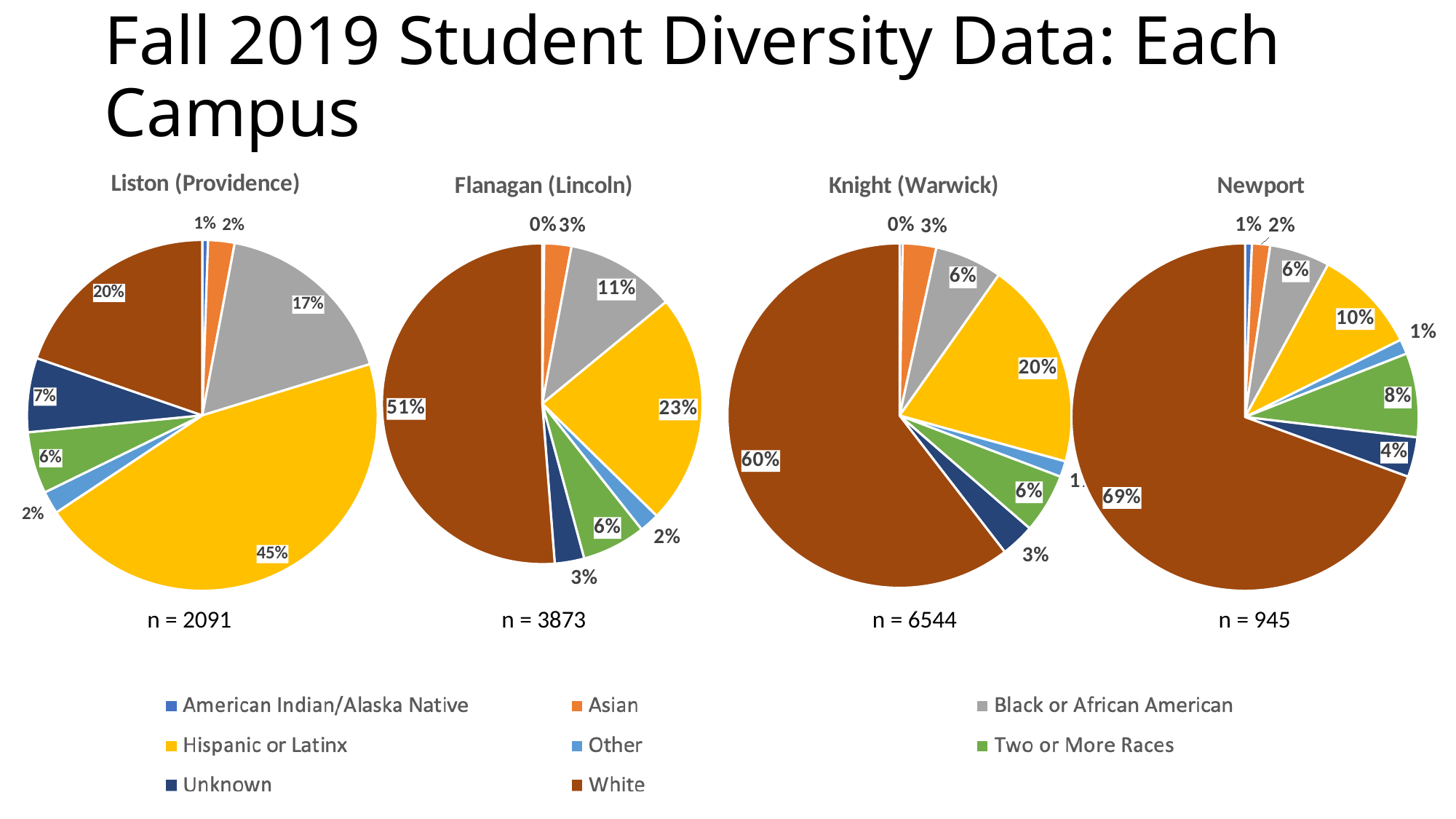
In the Liston (Providence) pie chart, what share of students are Hispanic or Latinx? 45% How many series does the legend list? 8 In the Flanagan (Lincoln) pie chart, what share of students are White? 51% In the Liston (Providence) pie chart, which category has the largest share? Hispanic or Latinx In the Newport pie chart, what share of students are Two or More Races? 8% In the Liston (Providence) pie chart, what share of students are Black or African American? 17% What kind of chart is used for each campus on this slide? Pie chart In the Knight (Warwick) pie chart, what share of students are Hispanic or Latinx? 20% What is the sample size (n) shown under the Knight (Warwick) pie chart? n = 6544 In the Knight (Warwick) pie chart, which is larger: the Black or African American share or the Hispanic or Latinx share? Hispanic or Latinx In the Flanagan (Lincoln) pie chart, what is the difference between the White share and the Hispanic or Latinx share? 28 percentage points In the Newport pie chart, which category has the largest share? White